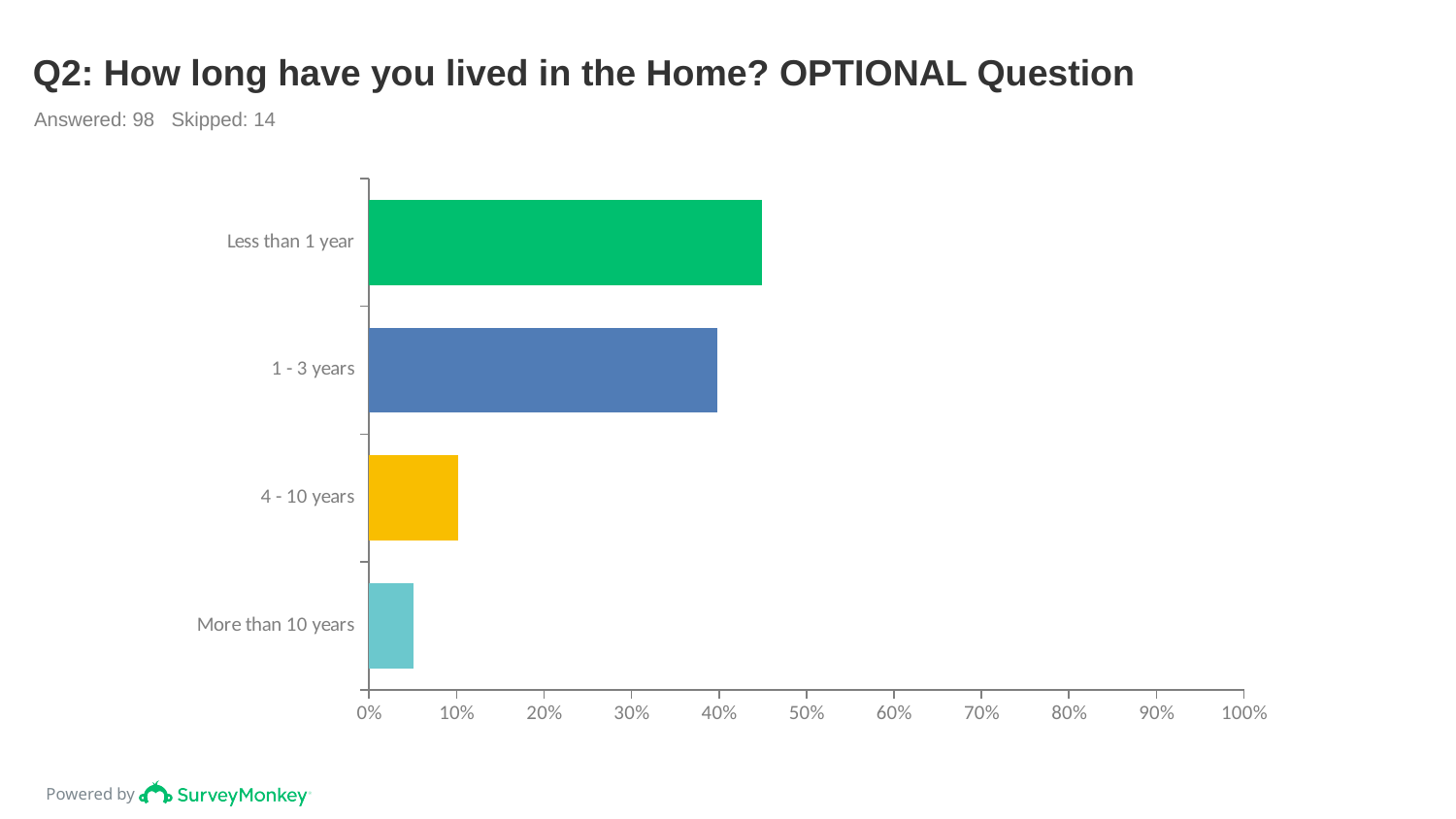
Is the value for 1 - 3 years greater or less than 30%? greater How many categories does the chart show? 4 Which category has the highest value? Less than 1 year How many respondents answered this question according to the slide? 98 Is the value for Less than 1 year greater or less than 40%? greater Is the value for More than 10 years greater or less than 10%? less What kind of chart is shown on the slide? bar chart Do the bar values increase or decrease going from the top category to the bottom category? decrease Which is larger, the value for 4 - 10 years or the value for More than 10 years? 4 - 10 years Which category has the lowest value? More than 10 years Which is larger, the value for Less than 1 year or the value for 1 - 3 years? Less than 1 year